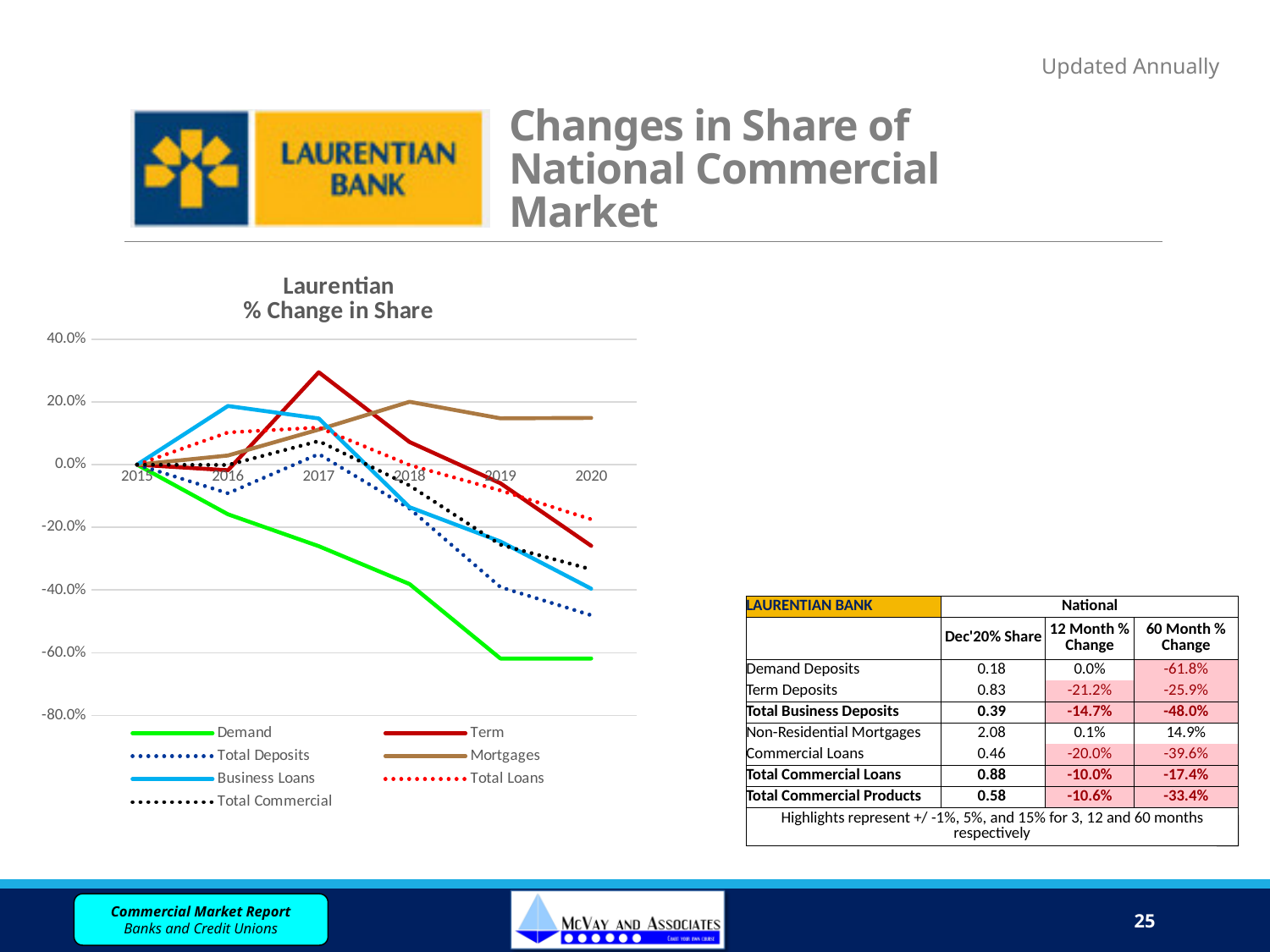
How many years are shown along the x axis of the chart? 6 Which series is highest in 2020? Mortgages Which series is lowest in 2020? Demand Which series is highest in 2017? Term What is the title of the chart? Laurentian % Change in Share What kind of chart is shown on the slide? line chart Is the value for Term in 2017 greater or less than 20.0%? greater Does the Demand series rise or fall from 2015 to 2020? fall In 2020, which is larger, the value for Demand or the value for Mortgages? Mortgages How many series does the legend of the chart list? 7 Is the value for Mortgages in 2020 greater or less than 0.0%? greater